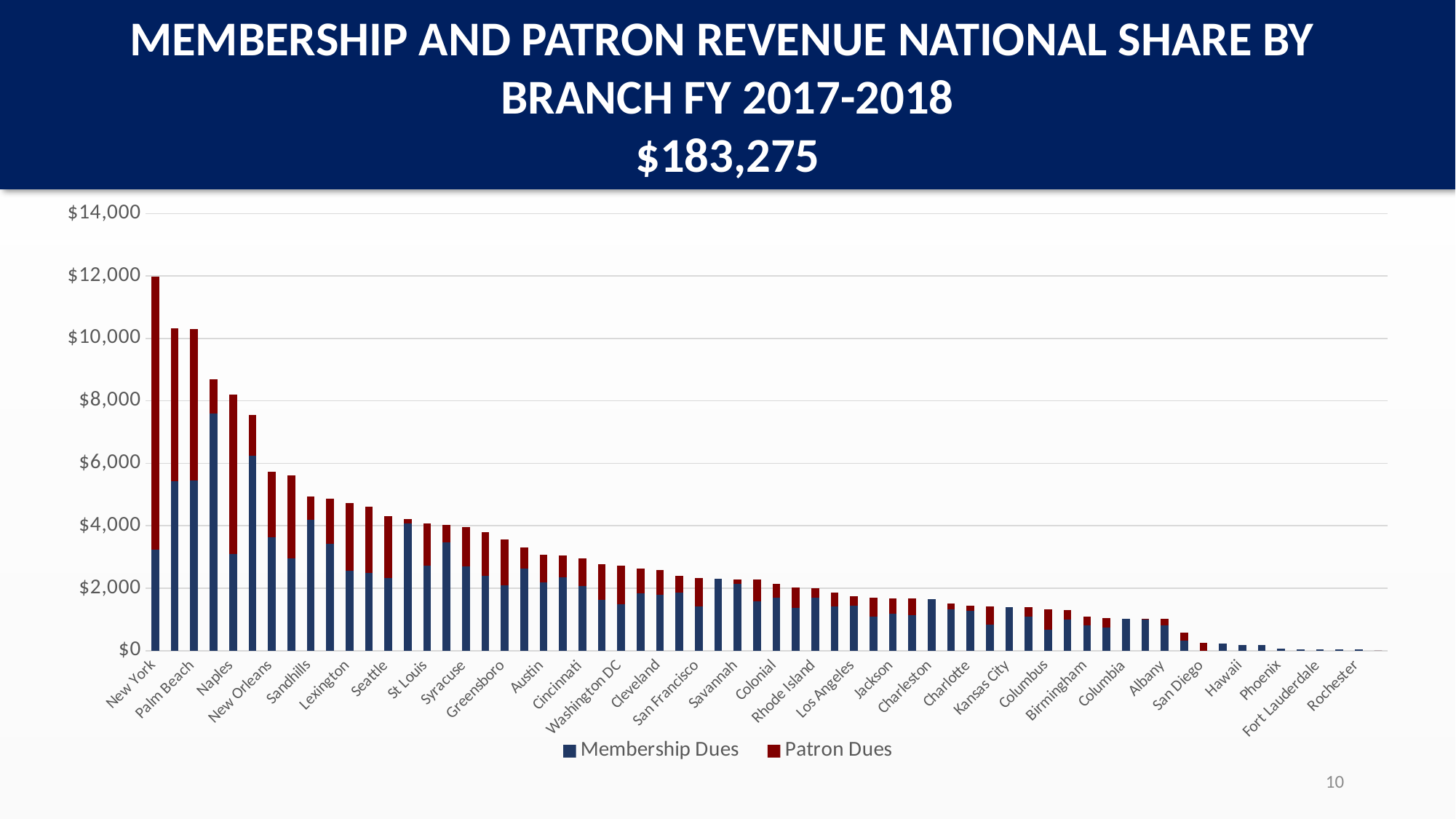
Do the total bar heights rise or fall moving from left to right along the x axis? fall Which branch has the highest total revenue bar? New York How many series does the legend list? 2 What are the two series named in the legend? Membership Dues and Patron Dues Is the total bar for New York greater or less than $10,000? greater Which has the larger total bar, New York or Naples? New York Is the total bar for New Orleans greater or less than $4,000? greater Is the total bar for Palm Beach greater or less than $8,000? greater What kind of chart is shown on the slide? Stacked bar chart What total amount is shown in the chart title? $183,275 Which series is shown in red? Patron Dues